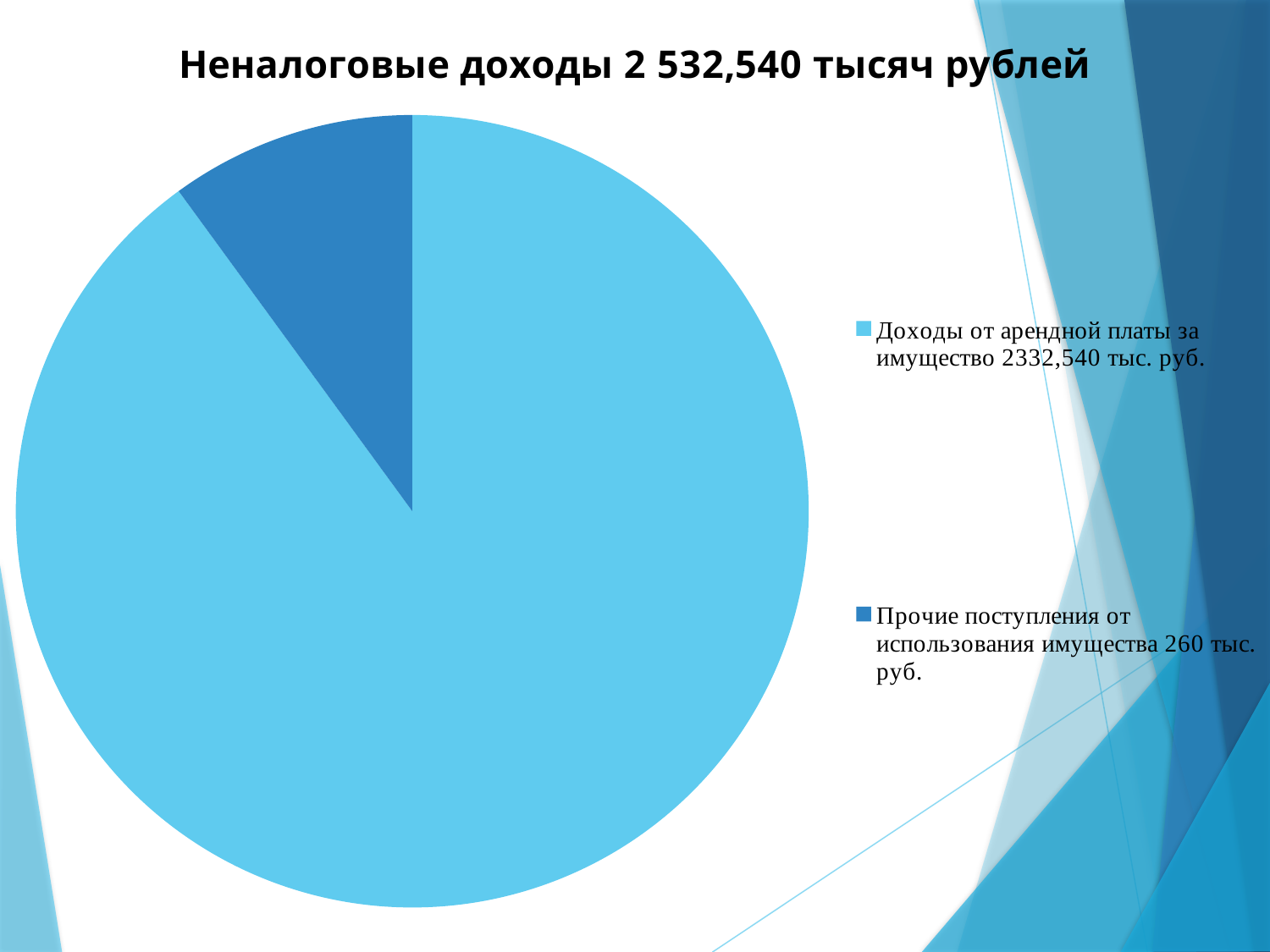
Which category has the smallest slice of the pie? Прочие поступления от использования имущества What value is given in the legend for "Доходы от арендной платы за имущество"? 2332,540 тыс. руб. Which is larger: "Доходы от арендной платы за имущество" or "Прочие поступления от использования имущества"? Доходы от арендной платы за имущество Which category is shown in the darker blue colour? Прочие поступления от использования имущества What kind of chart is shown on the slide? pie chart What value is given in the legend for "Прочие поступления от использования имущества"? 260 тыс. руб. How many entries does the legend list? 2 Which category has the largest slice of the pie? Доходы от арендной платы за имущество What is the difference between the value for "Доходы от арендной платы за имущество" and the value for "Прочие поступления от использования имущества"? 2072,540 тыс. руб. How many slices does the pie chart have? 2 What is the title of the chart? Неналоговые доходы 2 532,540 тысяч рублей